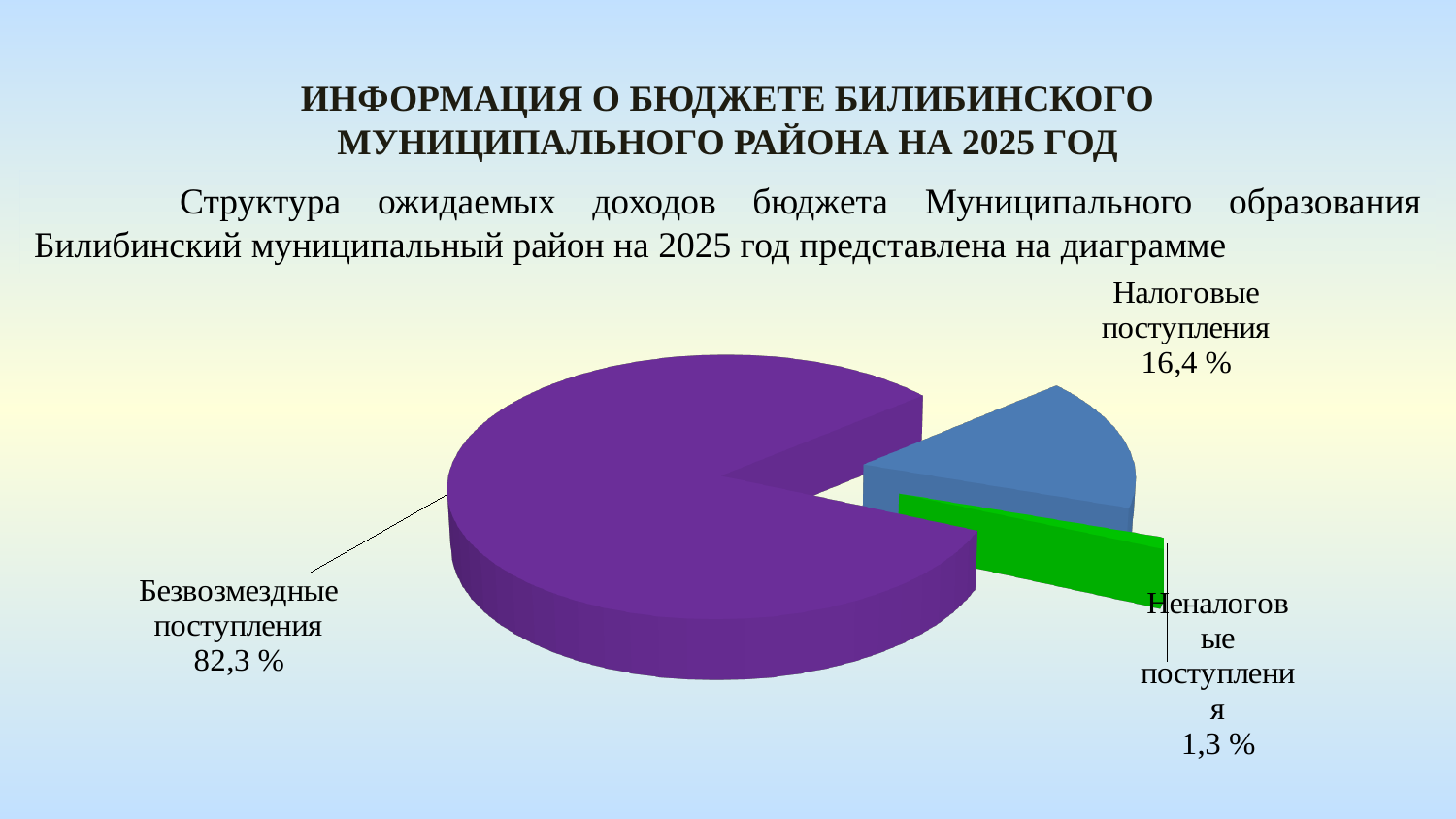
What kind of chart is shown on the slide? Pie chart Which slice of the pie chart is the largest? Безвозмездные поступления What is the difference in percentage points between Налоговые поступления and Неналоговые поступления? 15,1 Which slice of the pie chart is the smallest? Неналоговые поступления What colour is the slice for Безвозмездные поступления? Purple What share of the pie is labelled for Безвозмездные поступления? 82,3 % How many slices does the pie chart have? 3 What colour is the slice for Неналоговые поступления? Green Which is larger, Налоговые поступления or Неналоговые поступления? Налоговые поступления What share of the pie is labelled for Неналоговые поступления? 1,3 % What is the difference in percentage points between Безвозмездные поступления and Налоговые поступления? 65,9 What share of the pie is labelled for Налоговые поступления? 16,4 %